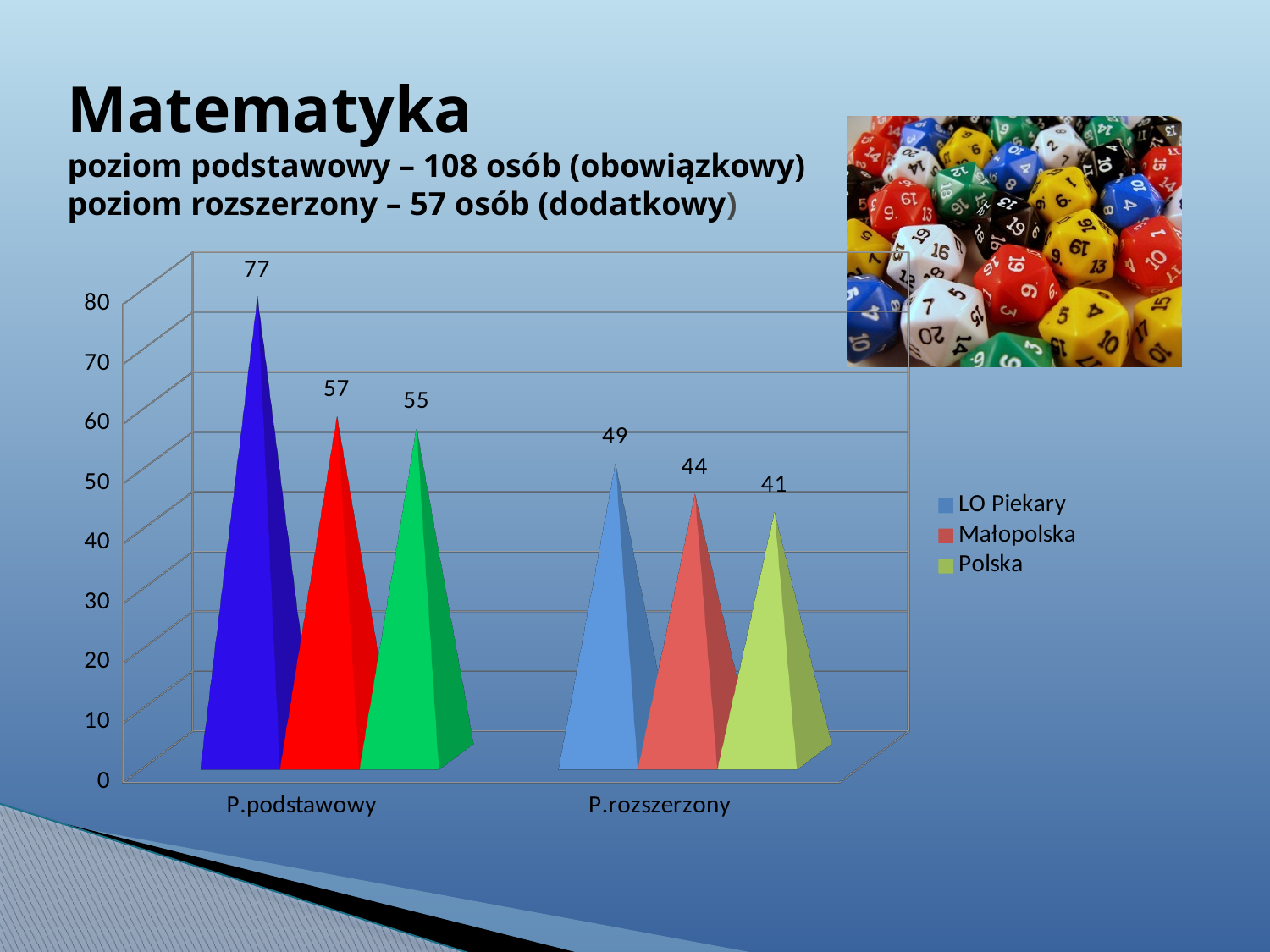
Which series has the lowest value in the P.rozszerzony category? Polska How many series does the legend list? 3 What is the value for Polska in the P.podstawowy category? 55 What is the value for LO Piekary in the P.podstawowy category? 77 Which series has the highest value in the P.podstawowy category? LO Piekary What is the value for LO Piekary in the P.rozszerzony category? 49 Which is larger: the Małopolska value for P.podstawowy or the Małopolska value for P.rozszerzony? P.podstawowy How many categories are shown on the x axis of the chart? 2 What kind of chart is shown on the slide? bar chart What is the difference between the LO Piekary values for P.podstawowy and P.rozszerzony? 28 What is the difference between the LO Piekary and Polska values in the P.podstawowy category? 22 What is the value for Małopolska in the P.rozszerzony category? 44